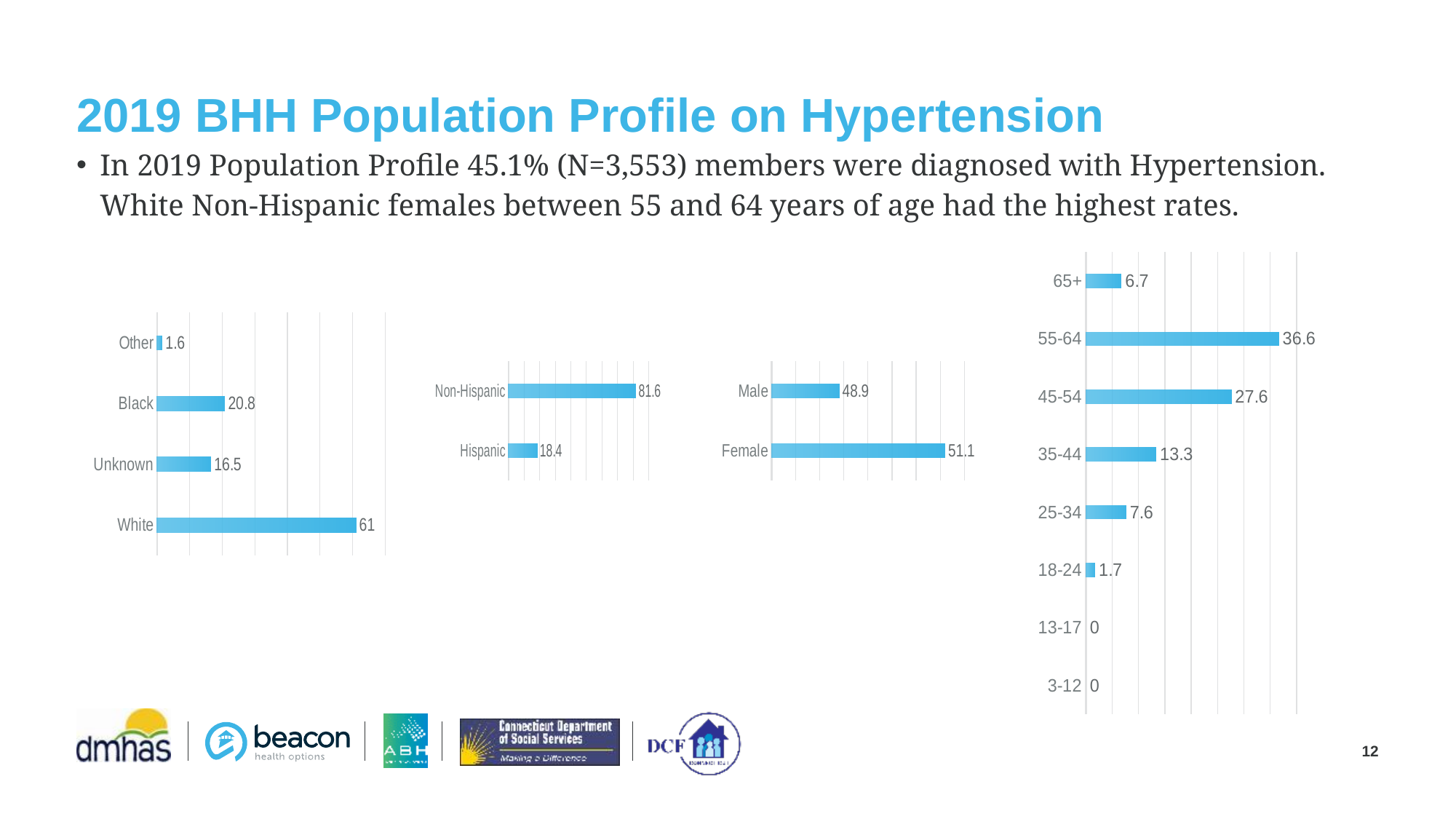
What kind of chart is the rightmost chart (age groups)? Bar chart In the rightmost chart (age groups), what is the value for 45-54? 27.6 In the second chart from the left (ethnicity), which is larger, Non-Hispanic or Hispanic? Non-Hispanic How many age groups are shown in the rightmost chart? 8 In the leftmost chart (race categories), which category has the lowest value? Other In the rightmost chart (age groups), which age group has the highest value? 55-64 In the leftmost chart (race categories), what is the value for White? 61 In the third chart from the left (gender), what is the value for Female? 51.1 In the leftmost chart (race categories), what is the difference between the values for Black and Unknown? 4.3 In the rightmost chart (age groups), what is the value for 18-24? 1.7 In the third chart from the left (gender), what is the difference between the Female and Male values? 2.2 In the second chart from the left (ethnicity), what is the value for Hispanic? 18.4